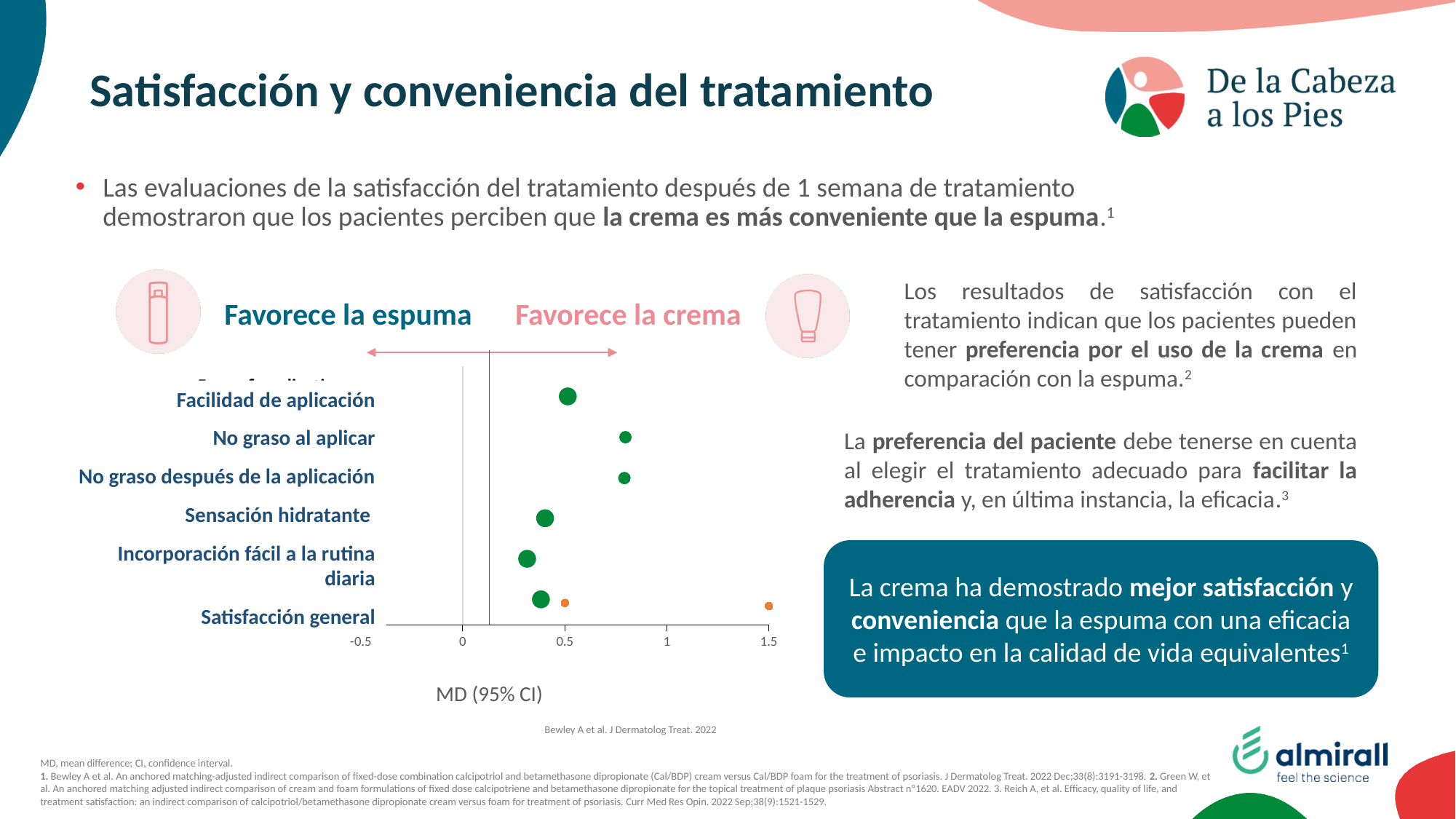
Which has the larger value, 'Facilidad de aplicación' or 'Incorporación fácil a la rutina diaria'? Facilidad de aplicación What is the label of the x axis of the chart? MD (95% CI) Is the value for 'Sensación hidratante' greater or less than 1? less Which side of the chart is labelled 'Favorece la crema', the left or the right? Right Is the value for 'Facilidad de aplicación' greater or less than 0? greater Which has the larger value, 'No graso después de la aplicación' or 'Sensación hidratante'? No graso después de la aplicación Is the value for 'No graso después de la aplicación' greater or less than 1? less What kind of chart is shown on the slide? Dot plot (scatter chart) Which has the larger value, 'No graso al aplicar' or 'Incorporación fácil a la rutina diaria'? No graso al aplicar How many satisfaction categories are plotted on the chart? 6